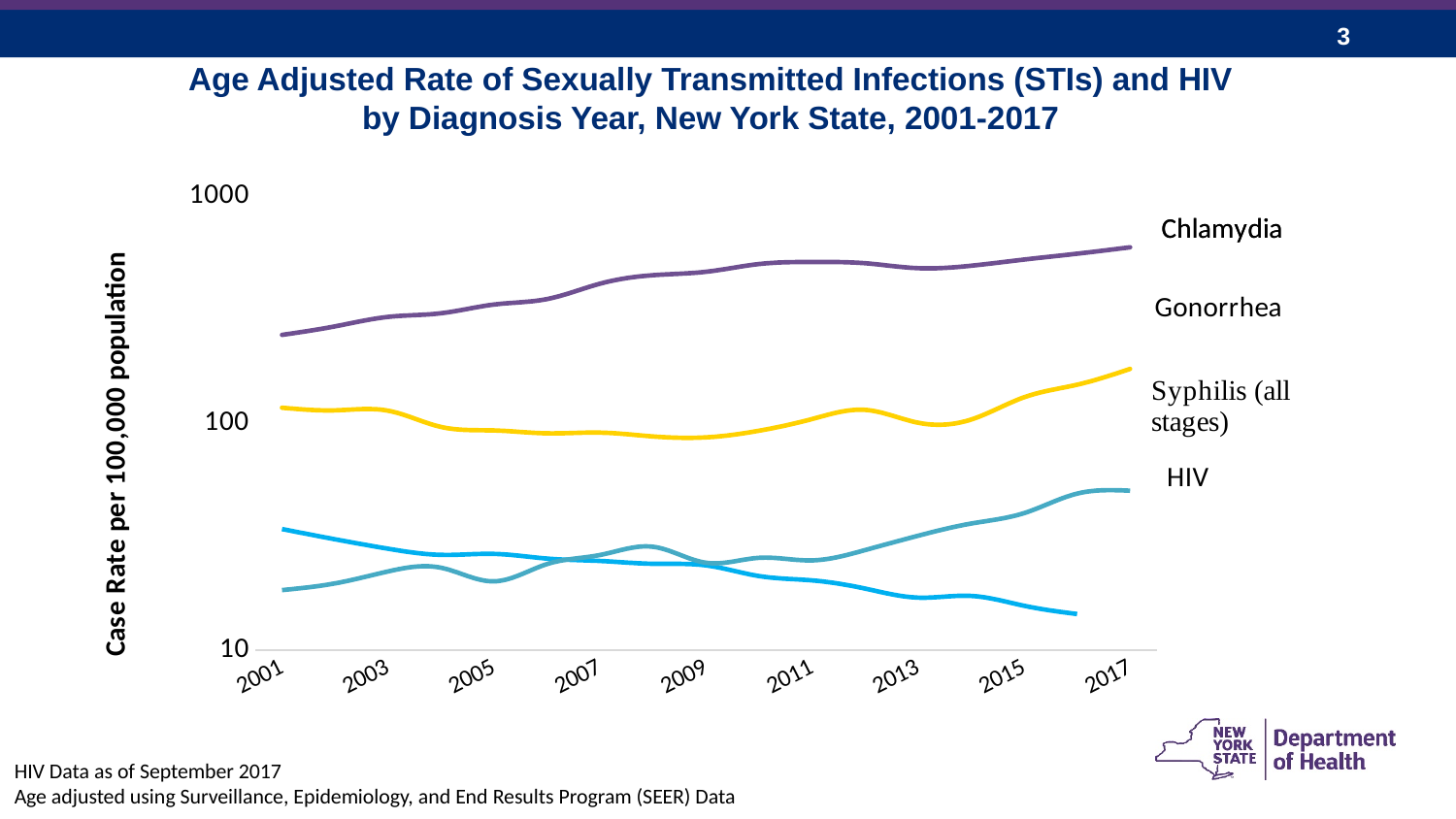
Which series has the lowest case rate at the end of the period shown? HIV In 2015, which has the larger case rate: Syphilis (all stages) or HIV? Syphilis (all stages) What is the label of the y axis? Case Rate per 100,000 population Is the Syphilis (all stages) case rate in 2017 greater or less than 100? less Does the HIV case rate rise or fall from 2001 to the end of its line? Fall How many series are plotted on the chart? 4 Is the Gonorrhea case rate in 2009 greater or less than 100? less In 2001, which has the larger case rate: Syphilis (all stages) or HIV? HIV Which infection has the highest case rate across all years shown? Chlamydia Is the Chlamydia case rate in 2001 greater or less than 100? greater Does the Syphilis (all stages) case rate rise or fall from 2001 to 2017? Rise What kind of chart is shown on the slide? Line chart